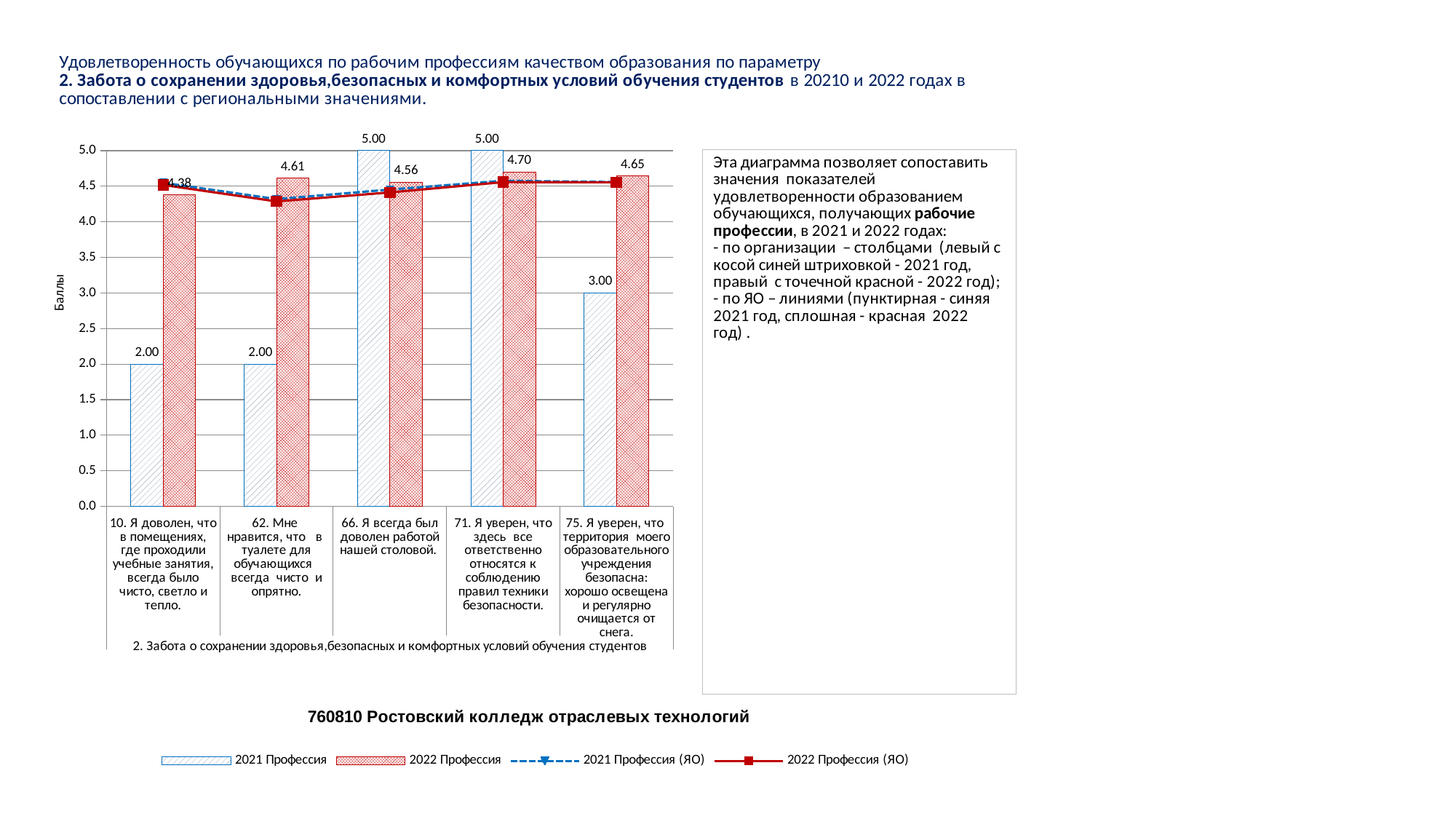
What is the label of the vertical axis of the chart? Баллы What is the difference between the 2022 Профессия and 2021 Профессия bars for category 10? 2.38 Which category has the lowest 2022 Профессия bar? 10. Я доволен, что в помещениях, где проходили учебные занятия, всегда было чисто, светло и тепло. How many categories are shown on the x axis of the chart? 5 What is the value of the 2021 Профессия bar for category 10 (Я доволен, что в помещениях, где проходили учебные занятия, всегда было чисто, светло и тепло)? 2.00 Is the 2022 Профессия (ЯО) line value for category 62 greater or less than 4.5? less How many series does the chart legend list? 4 What is the value of the 2022 Профессия bar for category 71 (Я уверен, что здесь все ответственно относятся к соблюдению правил техники безопасности)? 4.70 What is the value of the 2022 Профессия bar for category 62 (Мне нравится, что в туалете для обучающихся всегда чисто и опрятно)? 4.61 Which category has the highest 2022 Профессия bar? 71. Я уверен, что здесь все ответственно относятся к соблюдению правил техники безопасности. What is the value of the 2021 Профессия bar for category 75 (Я уверен, что территория моего образовательного учреждения безопасна)? 3.00 For category 66 (Я всегда был доволен работой нашей столовой), which is larger: the 2021 Профессия bar or the 2022 Профессия bar? 2021 Профессия